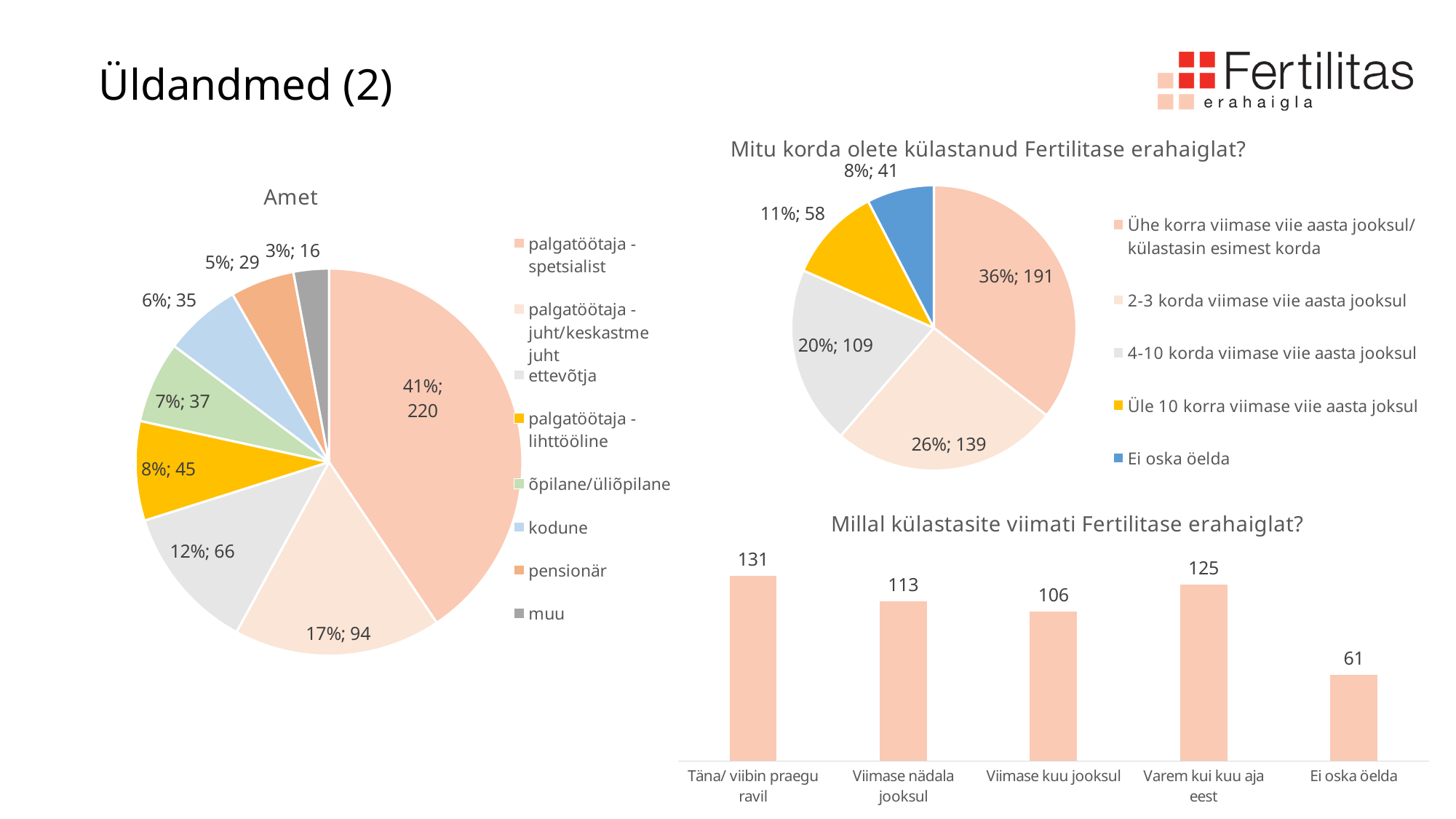
In the bar chart "Millal külastasite viimati Fertilitase erahaiglat?", which is larger: "Viimase nädala jooksul" or "Varem kui kuu aja eest"? Varem kui kuu aja eest In the "Amet" pie chart, what is the count shown for "kodune"? 35 What kind of chart is "Millal külastasite viimati Fertilitase erahaiglat?"? bar chart In the pie chart "Mitu korda olete külastanud Fertilitase erahaiglat?", what is the difference in count between "Ühe korra viimase viie aasta jooksul/ külastasin esimest korda" and "2-3 korda viimase viie aasta jooksul"? 52 In the "Amet" pie chart, what share of the pie does "ettevõtja" represent? 12% In the "Amet" pie chart, which category has the smallest slice? muu In the pie chart "Mitu korda olete külastanud Fertilitase erahaiglat?", what share does "Ei oska öelda" represent? 8% In the "Amet" pie chart, which category has the largest slice? palgatöötaja - spetsialist How many categories does the "Amet" pie chart have? 8 In the bar chart "Millal külastasite viimati Fertilitase erahaiglat?", which category has the lowest value? Ei oska öelda In the bar chart "Millal külastasite viimati Fertilitase erahaiglat?", what is the value for "Viimase kuu jooksul"? 106 In the pie chart "Mitu korda olete külastanud Fertilitase erahaiglat?", what is the count for "4-10 korda viimase viie aasta jooksul"? 109